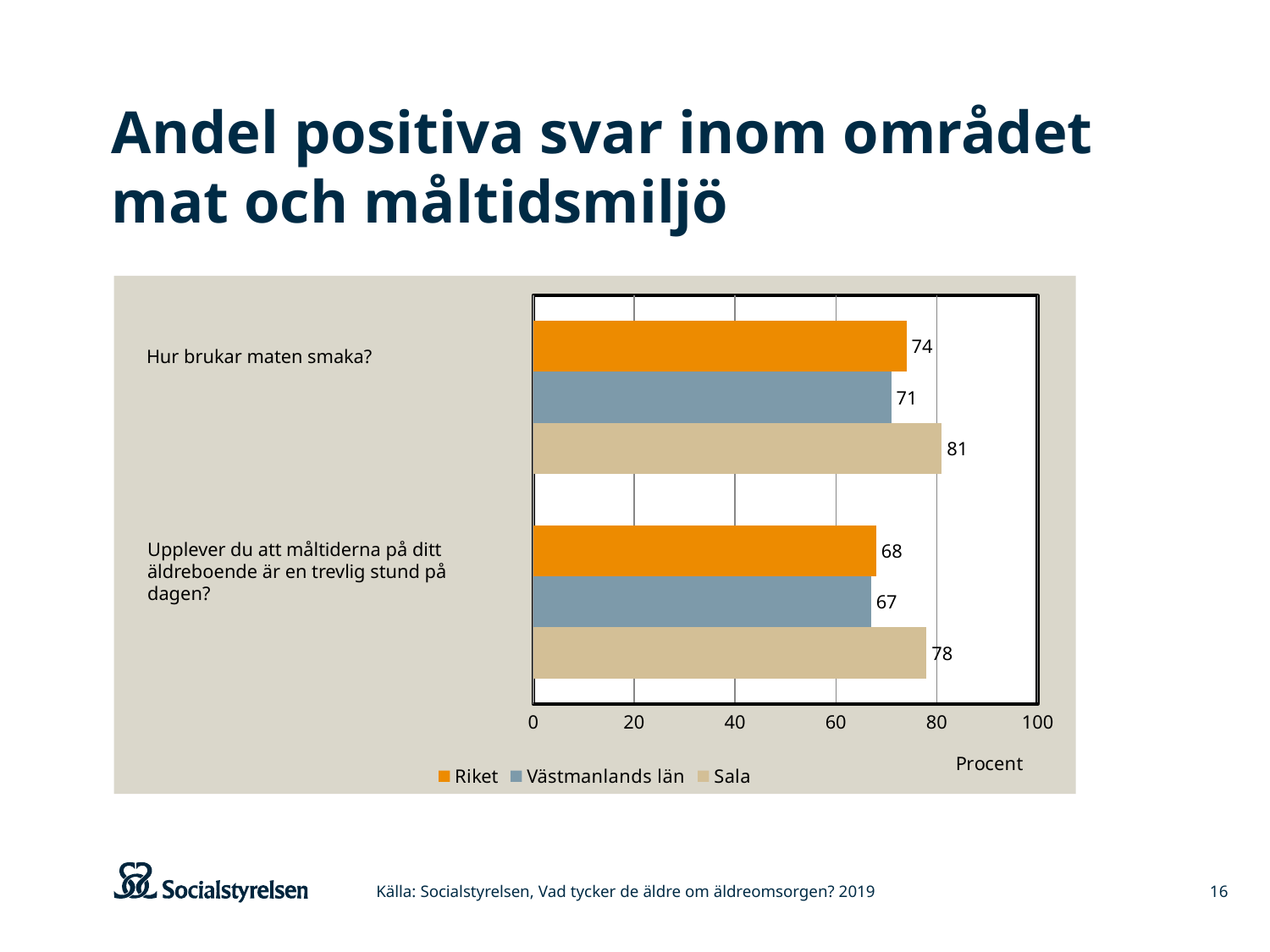
What is the value for Riket for the question "Upplever du att måltiderna på ditt äldreboende är en trevlig stund på dagen?"? 68 What is the value for Sala for the question "Hur brukar maten smaka?"? 81 How many series does the legend list? 3 What kind of chart is shown on the slide? Bar chart What is the value for Västmanlands län for the question "Hur brukar maten smaka?"? 71 Which series has the highest value for "Hur brukar maten smaka?"? Sala What unit is shown on the horizontal axis of the chart? Procent What is the difference between Sala and Riket for "Hur brukar maten smaka?"? 7 Which is larger: Riket for "Hur brukar maten smaka?" or Riket for "Upplever du att måltiderna på ditt äldreboende är en trevlig stund på dagen?"? Hur brukar maten smaka? Which series has the lowest value for "Upplever du att måltiderna på ditt äldreboende är en trevlig stund på dagen?"? Västmanlands län Is the value for Sala for "Upplever du att måltiderna på ditt äldreboende är en trevlig stund på dagen?" greater or less than 60? greater What is the difference between Sala and Västmanlands län for "Upplever du att måltiderna på ditt äldreboende är en trevlig stund på dagen?"? 11